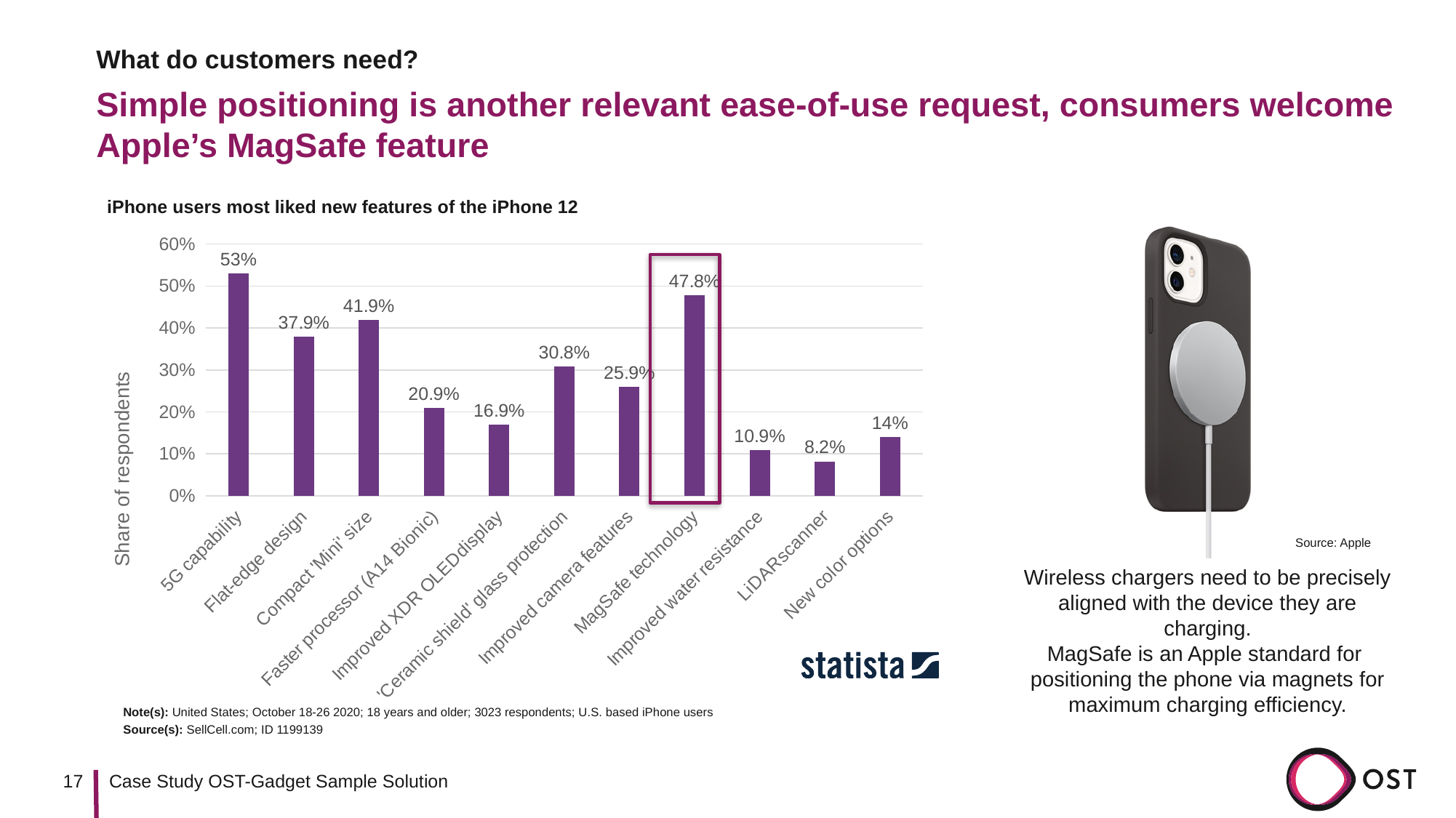
What is the value for 'Ceramic shield' glass protection? 30.8% Is the value for Improved camera features greater or less than 30%? less What share of respondents liked the MagSafe technology feature? 47.8% What is the difference between the shares for 5G capability and MagSafe technology? 5.2% How many features are shown on the chart? 11 What share of respondents liked the 5G capability feature? 53% Which feature has the lowest share of respondents? LiDAR scanner What is the title of the chart? iPhone users most liked new features of the iPhone 12 Which has a larger share of respondents: Flat-edge design or Compact 'Mini' size? Compact 'Mini' size Which feature has the highest share of respondents? 5G capability What is the label of the y axis? Share of respondents What type of chart is used to show the most liked iPhone 12 features? bar chart